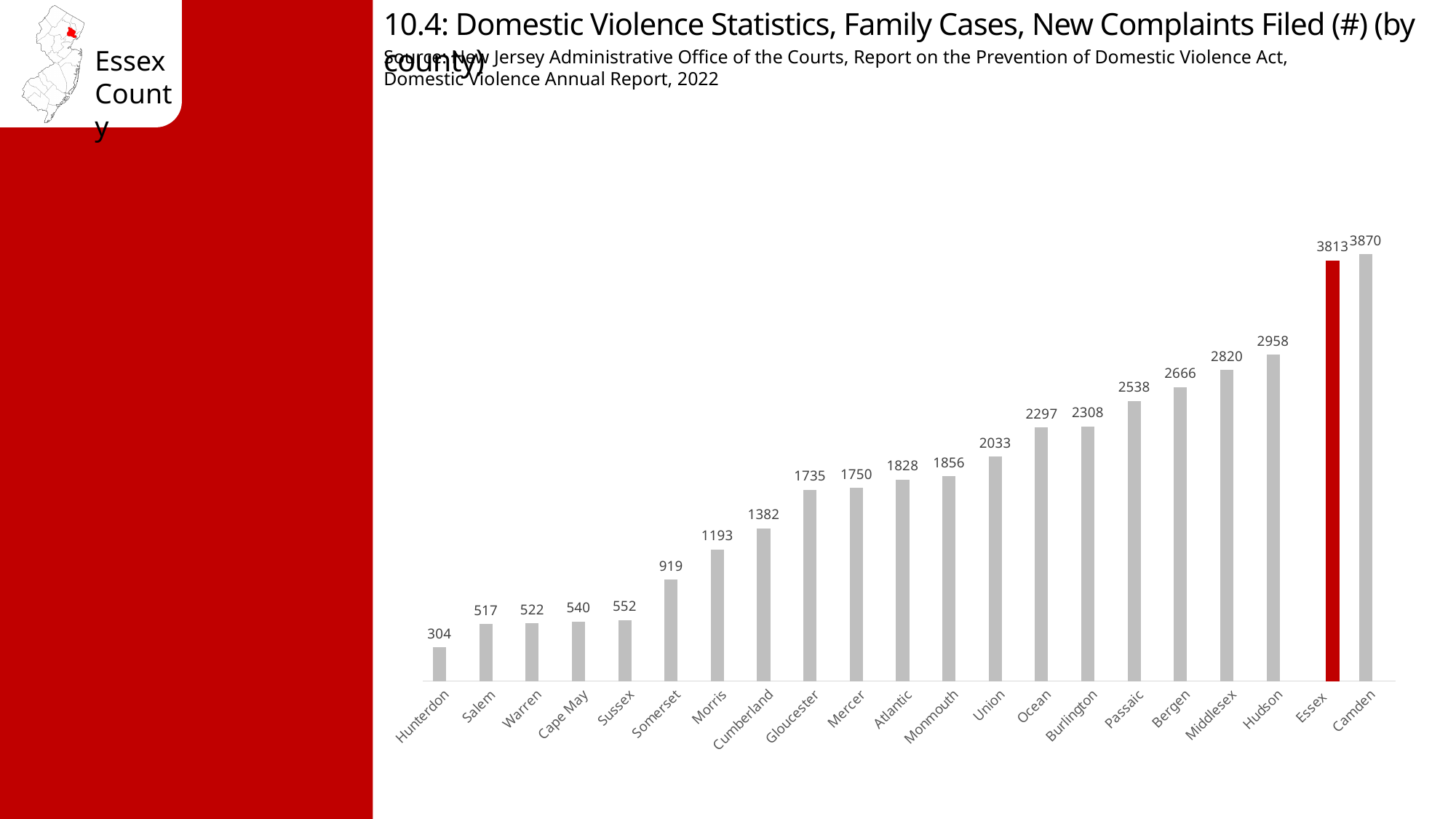
Do the values rise or fall from left to right along the x axis? Rise What is the difference between the values for Hudson and Middlesex? 138 How many counties are shown in the chart? 21 Which county has the lowest number of new complaints filed? Hunterdon What is the difference between the values for Camden and Essex? 57 What kind of chart is shown on the slide? Bar chart Which county's bar is highlighted in red? Essex Which is larger, the value for Ocean or the value for Union? Ocean Which county has the highest number of new complaints filed? Camden What is the value for Middlesex? 2820 What is the value for Essex? 3813 What is the value for Hunterdon? 304